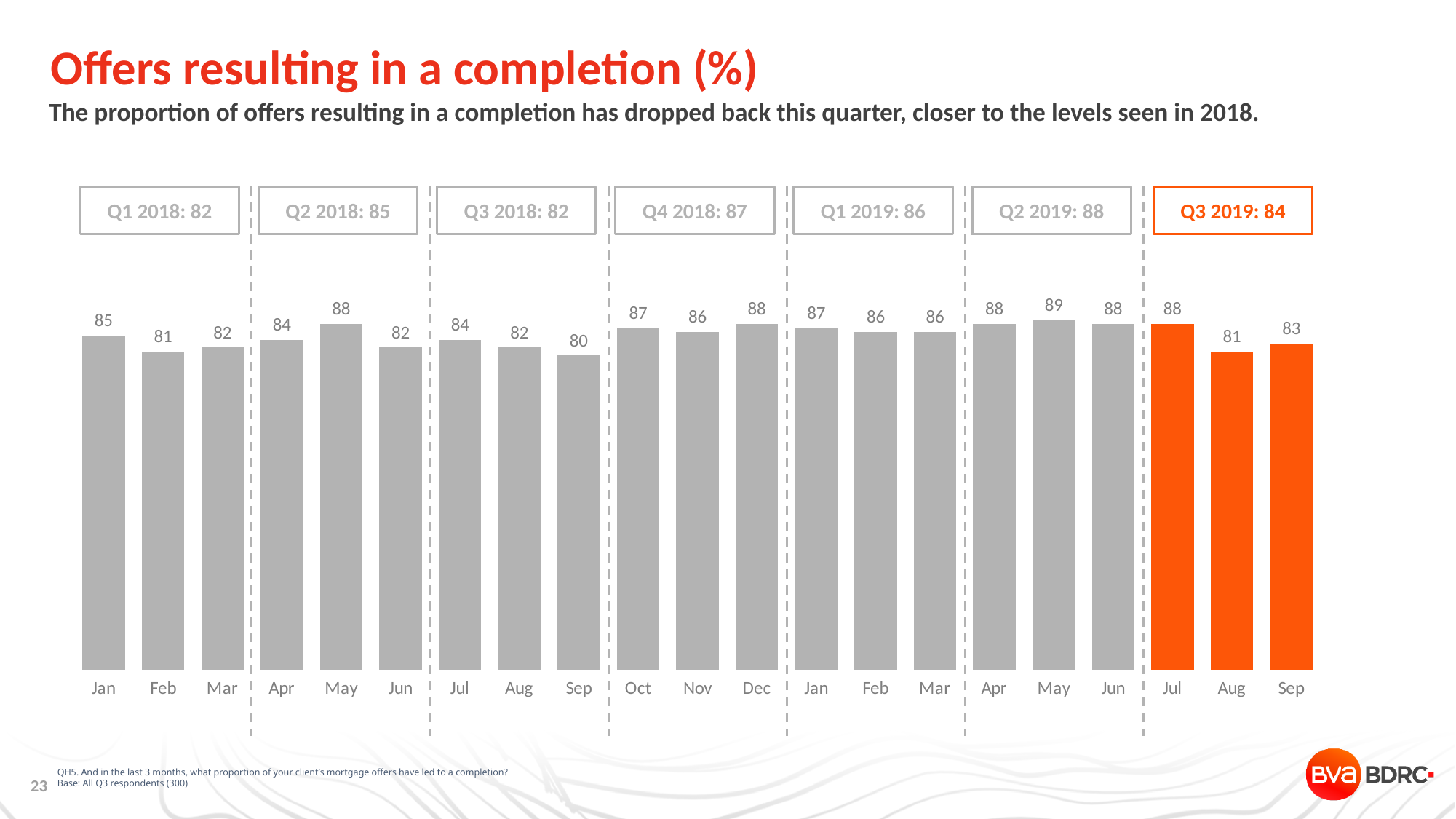
Which quarter's bars are highlighted in orange? Q3 2019 Which is larger, the value for Oct 2018 or the value for Nov 2018? Oct 2018 What type of chart is shown on the slide? Bar chart What is the difference between the values for Jul 2019 and Aug 2019? 7 What is the value for Sep 2019 (the last bar) in the chart? 83 What is the value for May 2018 in the chart? 88 Which month has the lowest value in the chart? Sep 2018 (80) How many monthly bars are plotted in the chart? 21 How many quarterly summary boxes are shown above the chart? 7 Which month has the highest value in the chart? May 2019 (89) What is the difference between the Q2 2019 and Q3 2019 quarterly figures? 4 What is the quarterly figure shown for Q3 2019? 84